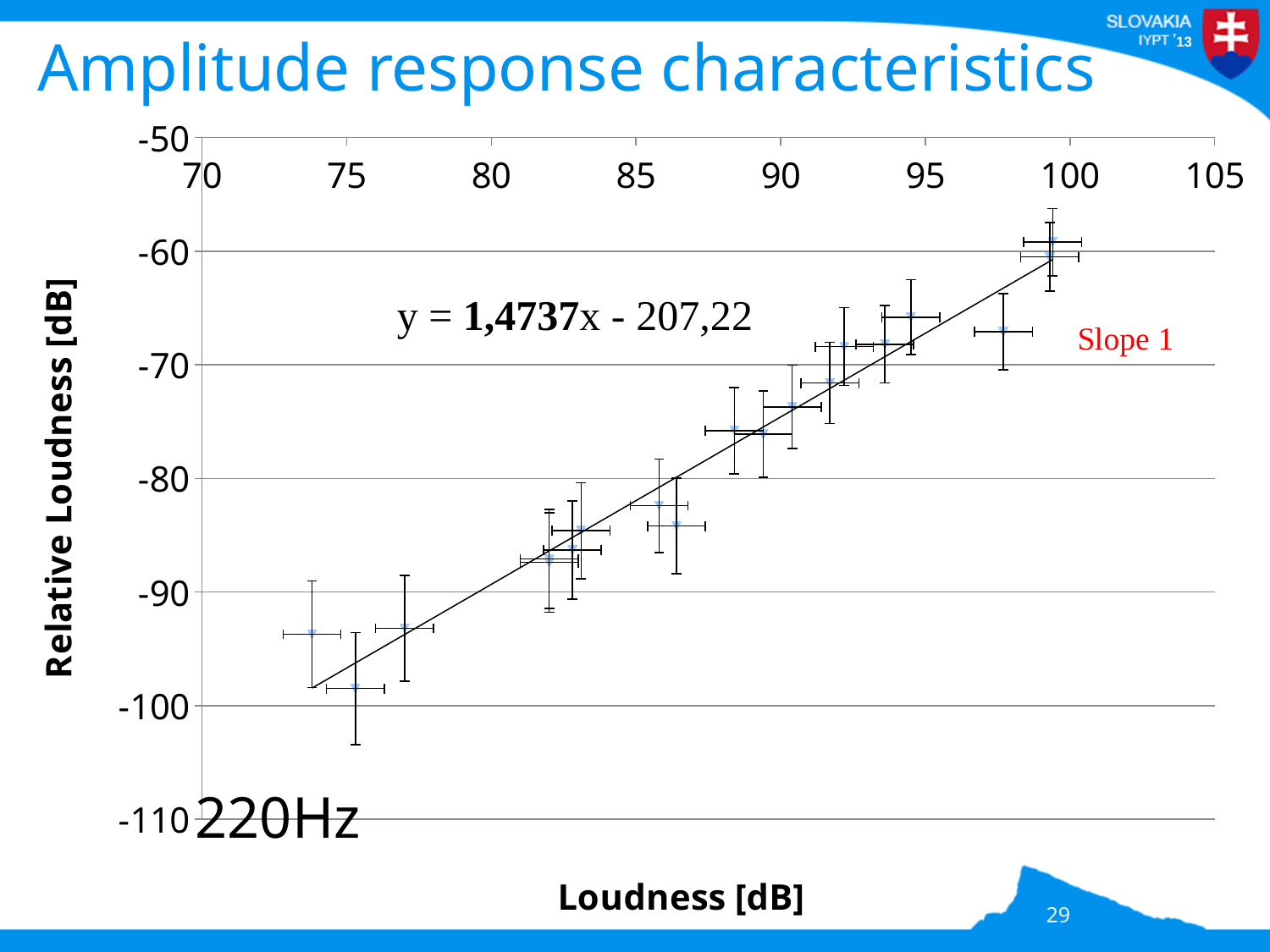
What is the equation of the fitted line shown on the chart? y = 1,4737x - 207,22 Is the Relative Loudness of the data point near 75 dB Loudness greater or less than -90? less Which data point has the lowest Relative Loudness: the one near 75 dB Loudness or the one near 77 dB Loudness? the one near 75 dB What is the highest value shown on the x axis? 105 Is the Relative Loudness of the data point near 99.5 dB Loudness greater or less than -70? greater Do the plotted values rise or fall as Loudness increases along the x axis? rise What is the slope of the fitted line according to the equation on the chart? 1,4737 Is the Relative Loudness of the data point near 88.5 dB Loudness greater or less than -80? greater What is the label of the y axis? Relative Loudness [dB] What kind of chart is shown on the slide? scatter plot